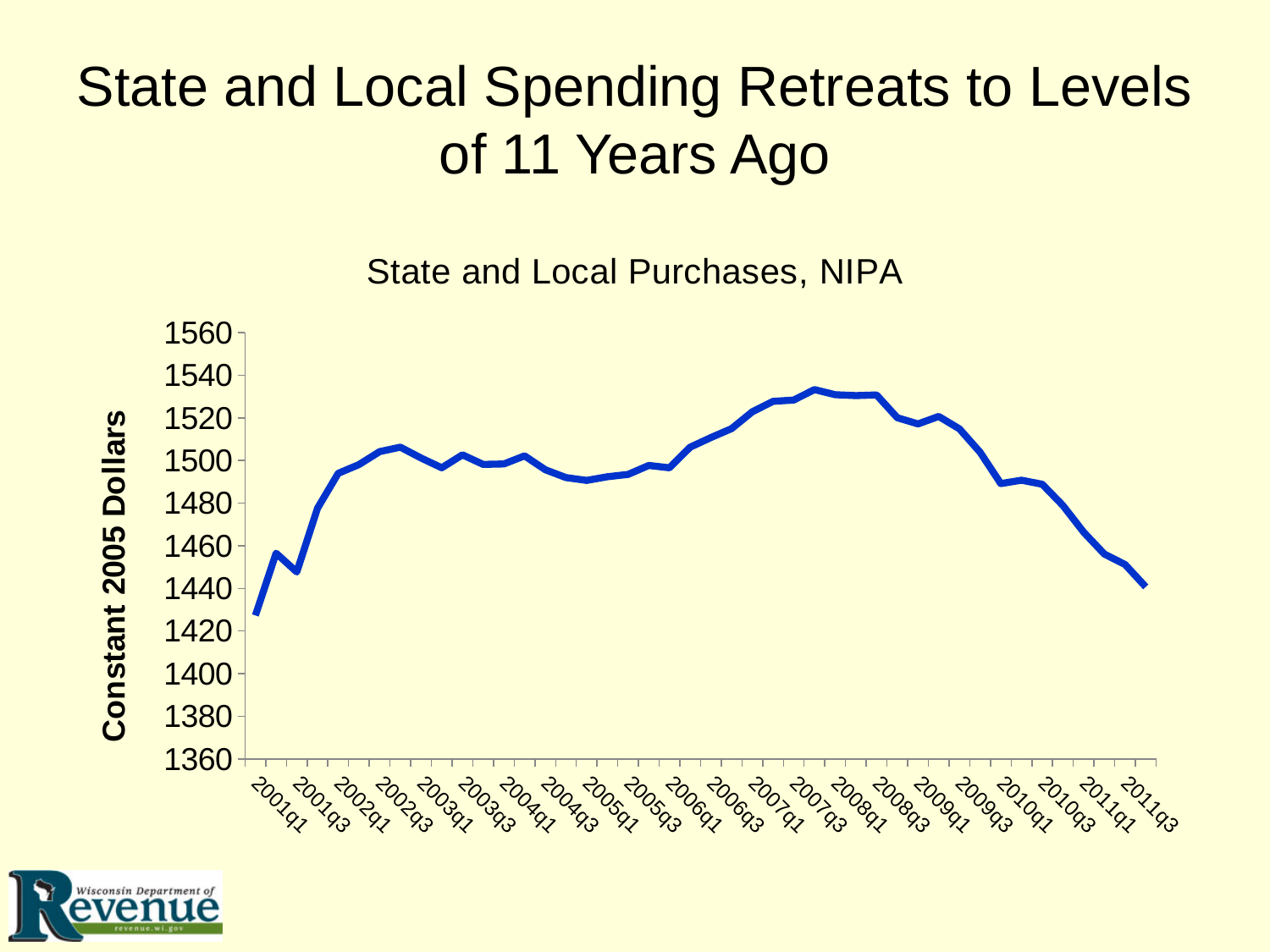
Which is larger, the value for 2007q3 or the value for 2011q3? 2007q3 What is the label on the vertical axis of the chart? Constant 2005 Dollars Is the value for 2011q3 greater or less than 1460? less Do the values rise or fall from 2008q1 to 2011q3? fall Is the value for 2001q1 greater or less than 1440? less What kind of chart is shown on the slide? line chart Around which quarter does the line reach its highest value? 2007q4 Which quarter has the lowest value on the chart? 2001q1 What is the title of the chart? State and Local Purchases, NIPA Is the value for 2007q3 greater or less than 1520? greater